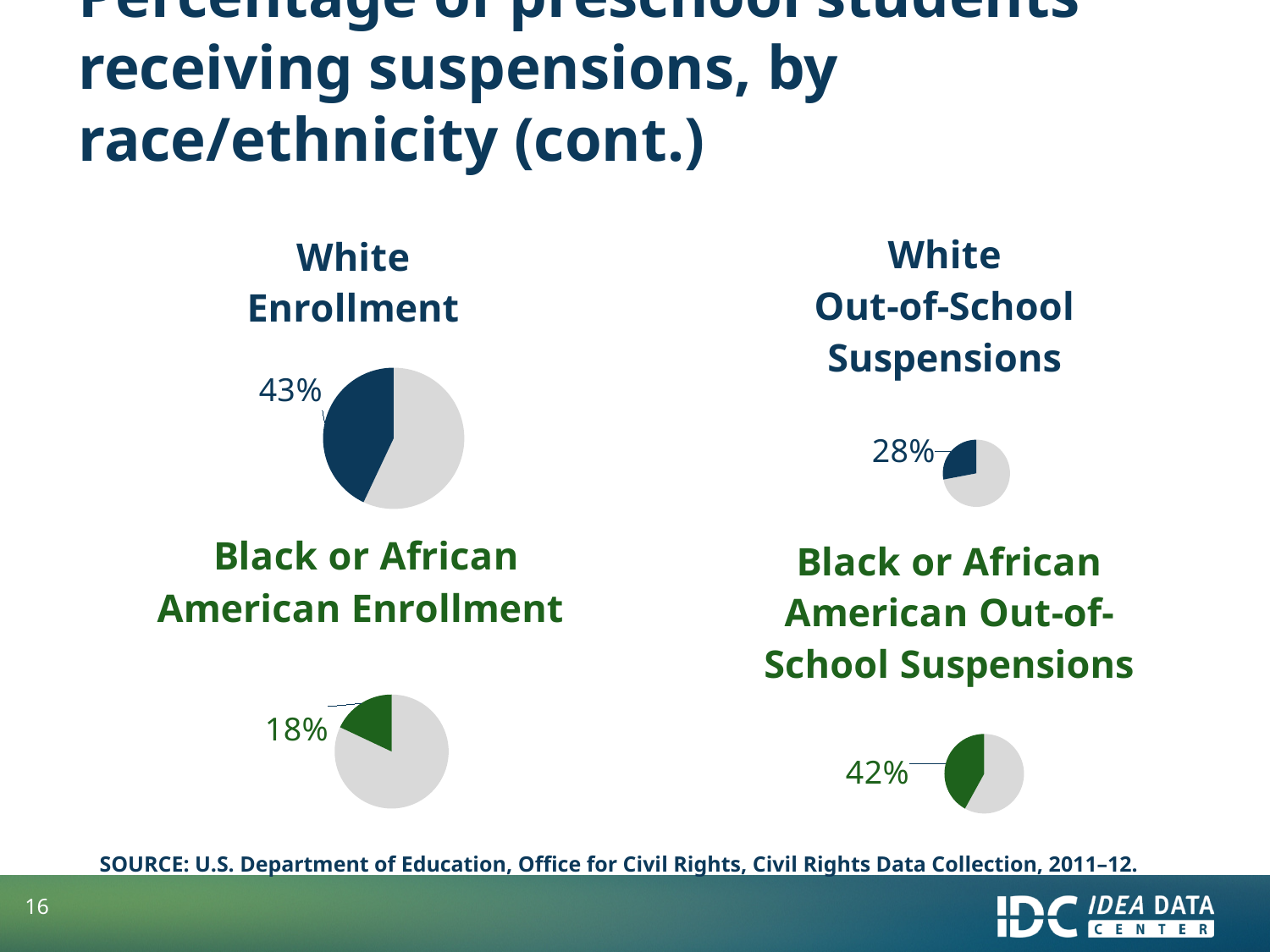
In the "Black or African American Out-of-School Suspensions" chart, what percentage is shown for the highlighted slice? 42% In the "White Out-of-School Suspensions" chart, what percentage is shown for the highlighted slice? 28% Of the four pie charts, which has the smallest labeled share? Black or African American Enrollment What kind of chart is used for "White Enrollment"? Pie chart How many pie charts are shown on the slide? 4 In the "Black or African American Enrollment" chart, what percentage is shown for the highlighted slice? 18% Which is larger: the labeled share in the "Black or African American Enrollment" chart or the labeled share in the "Black or African American Out-of-School Suspensions" chart? Black or African American Out-of-School Suspensions What is the difference between the labeled share in the "White Enrollment" chart and the labeled share in the "White Out-of-School Suspensions" chart? 15% What colour is the highlighted slice in the "Black or African American Enrollment" chart? Green What is the difference between the labeled share in the "Black or African American Out-of-School Suspensions" chart and the labeled share in the "Black or African American Enrollment" chart? 24% In the "White Enrollment" chart, what percentage is shown for the highlighted slice? 43% Which is larger: the labeled share in the "White Enrollment" chart or the labeled share in the "White Out-of-School Suspensions" chart? White Enrollment